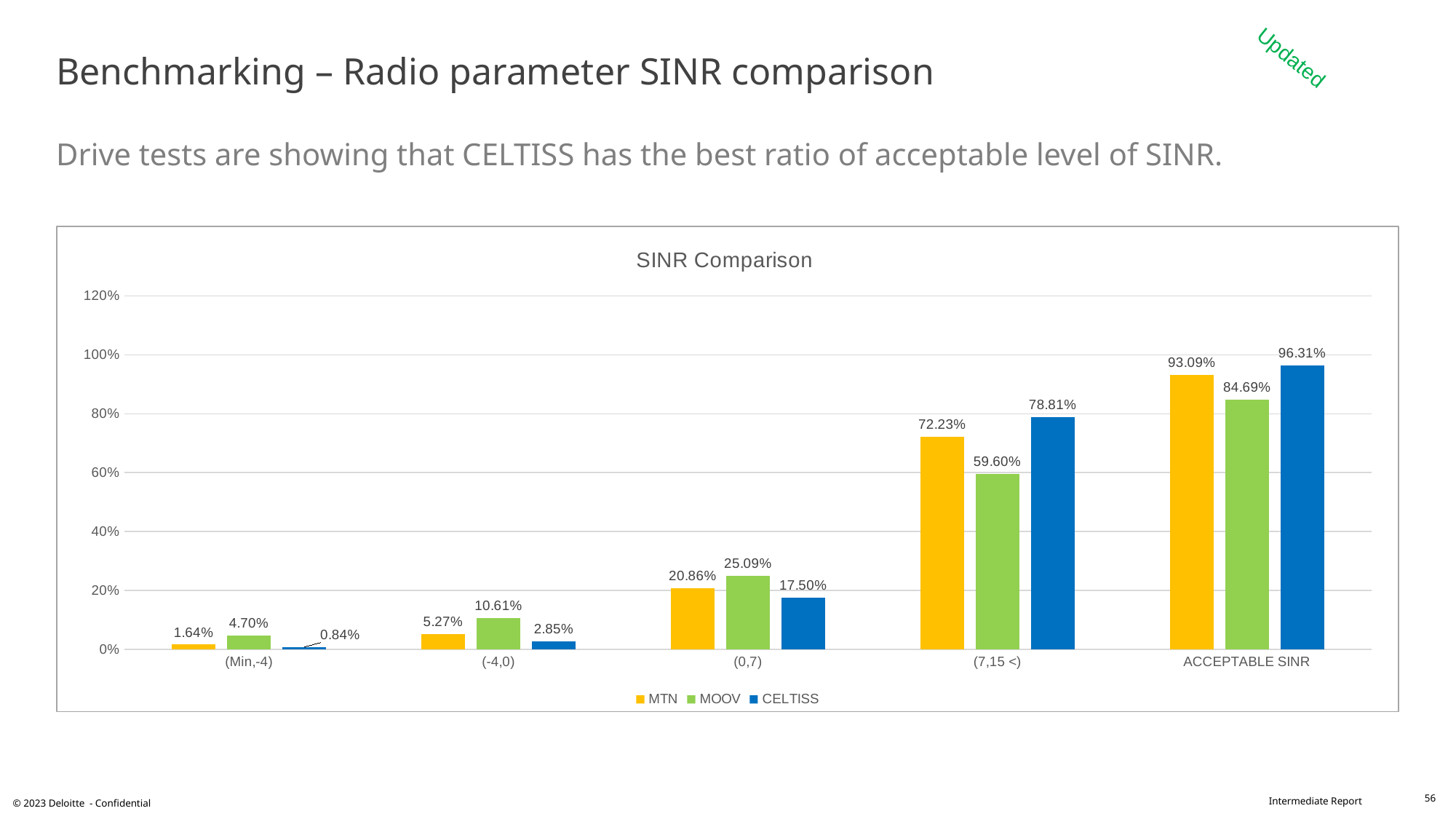
What is the value for CELTISS in the ACCEPTABLE SINR category? 96.31% What is the value for MTN in the (0,7) category? 20.86% How many categories are shown on the x axis? 5 What is the difference between CELTISS and MTN in the ACCEPTABLE SINR category? 3.22% What is the value for MOOV in the (7,15 <) category? 59.60% Which is larger in the (0,7) category: MOOV or CELTISS? MOOV What is the title of the chart? SINR Comparison Which series has the lowest value in the (Min,-4) category? CELTISS Is the value for MTN in the (7,15 <) category greater or less than 80%? less Which series has the highest value in the ACCEPTABLE SINR category? CELTISS How many series does the legend list? 3 What kind of chart is shown? bar chart